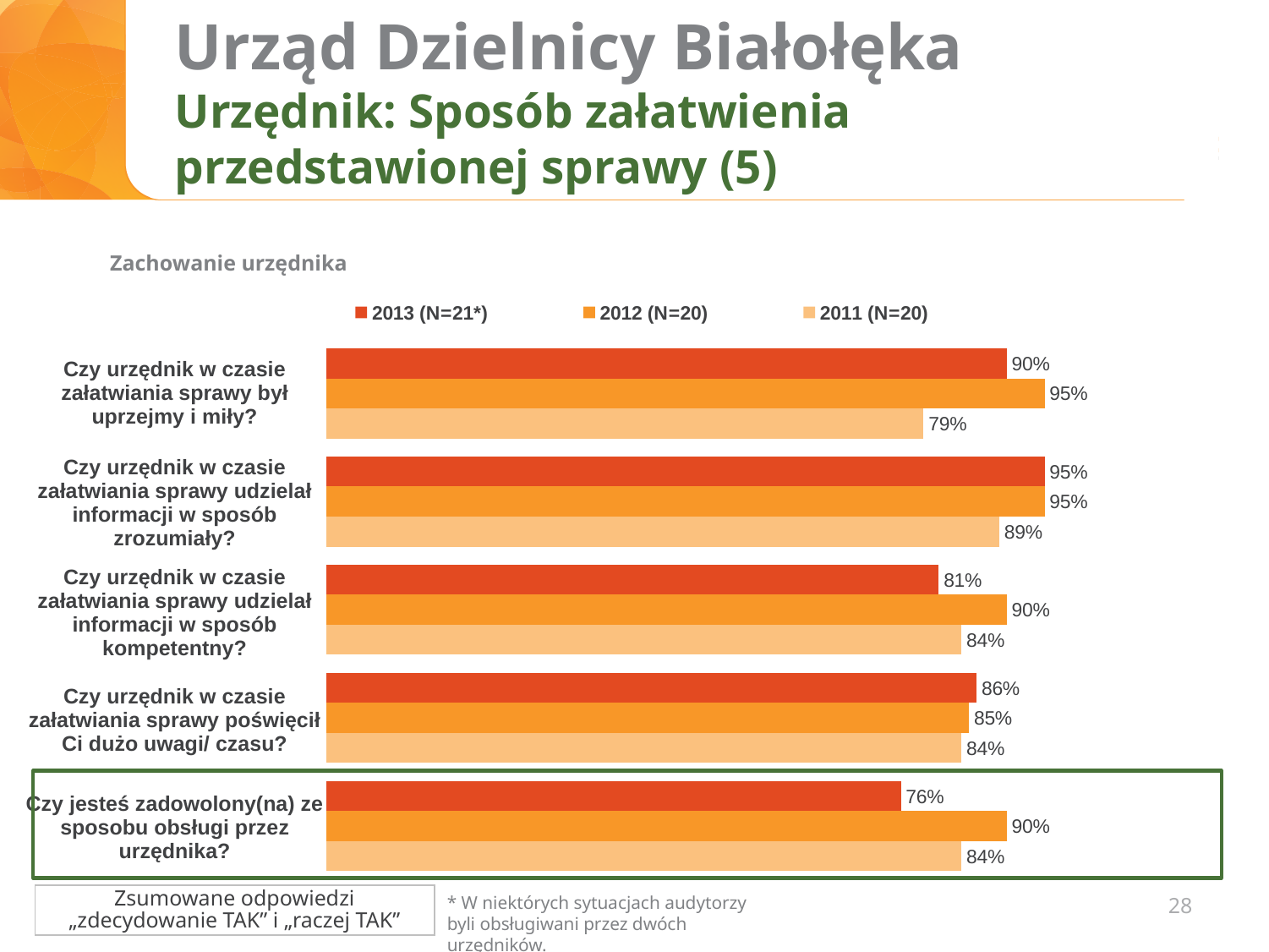
What is the 2012 (N=20) value for "Czy urzędnik w czasie załatwiania sprawy udzielał informacji w sposób kompetentny?"? 90% What is the 2013 (N=21*) value for "Czy jesteś zadowolony(na) ze sposobu obsługi przez urzędnika?"? 76% What is the difference between the 2012 and 2013 values for "Czy jesteś zadowolony(na) ze sposobu obsługi przez urzędnika?"? 14 percentage points How many series does the legend list? 3 What is the difference between the 2013 and 2011 values for "Czy urzędnik w czasie załatwiania sprawy był uprzejmy i miły?"? 11 percentage points Which question has the highest 2013 (N=21*) value? Czy urzędnik w czasie załatwiania sprawy udzielał informacji w sposób zrozumiały? What is the 2011 (N=20) value for "Czy urzędnik w czasie załatwiania sprawy był uprzejmy i miły?"? 79% What type of chart is shown on the slide? Bar chart For "Czy urzędnik w czasie załatwiania sprawy był uprzejmy i miły?", which year has the larger value: 2012 or 2011? 2012 How many questions (categories) are shown on the chart? 5 What is the title shown above the chart? Zachowanie urzędnika Which question has the lowest 2013 (N=21*) value? Czy jesteś zadowolony(na) ze sposobu obsługi przez urzędnika?